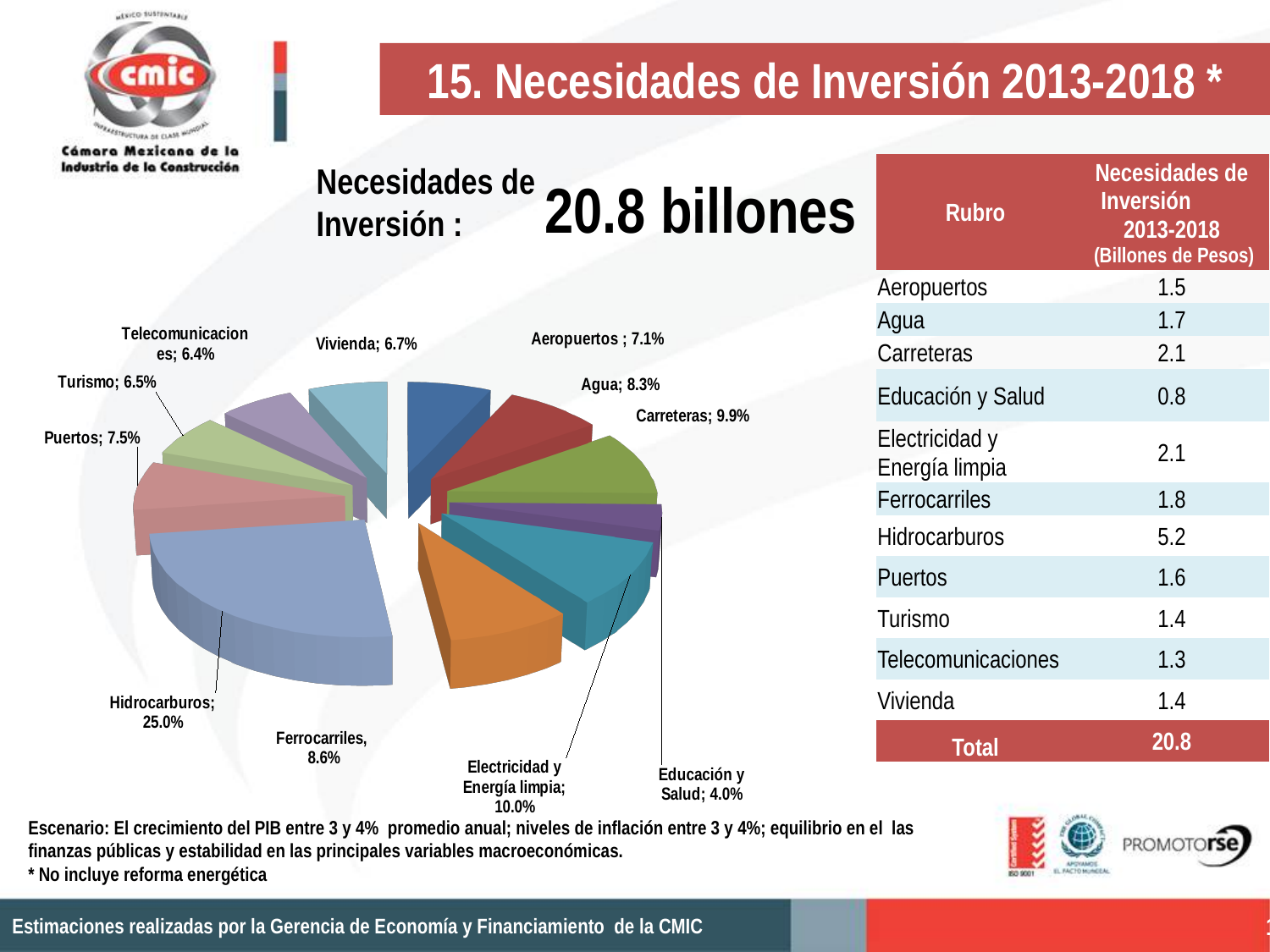
What is the difference in percentage points between Hidrocarburos and Electricidad y Energía limpia in the pie chart? 15.0 What percentage is shown for Electricidad y Energía limpia in the pie chart? 10.0% How many slices does the pie chart have? 11 Which category has the smallest slice of the pie chart? Educación y Salud What is the difference in percentage points between Agua and Aeropuertos in the pie chart? 1.2 Which has a larger share in the pie chart, Carreteras or Agua? Carreteras What share of the pie does Hidrocarburos represent? 25.0% What percentage is shown for Carreteras in the pie chart? 9.9% Which category has the largest slice of the pie chart? Hidrocarburos What kind of chart is shown on the slide? pie chart Which has a larger share in the pie chart, Ferrocarriles or Vivienda? Ferrocarriles What percentage is shown for Telecomunicaciones in the pie chart? 6.4%